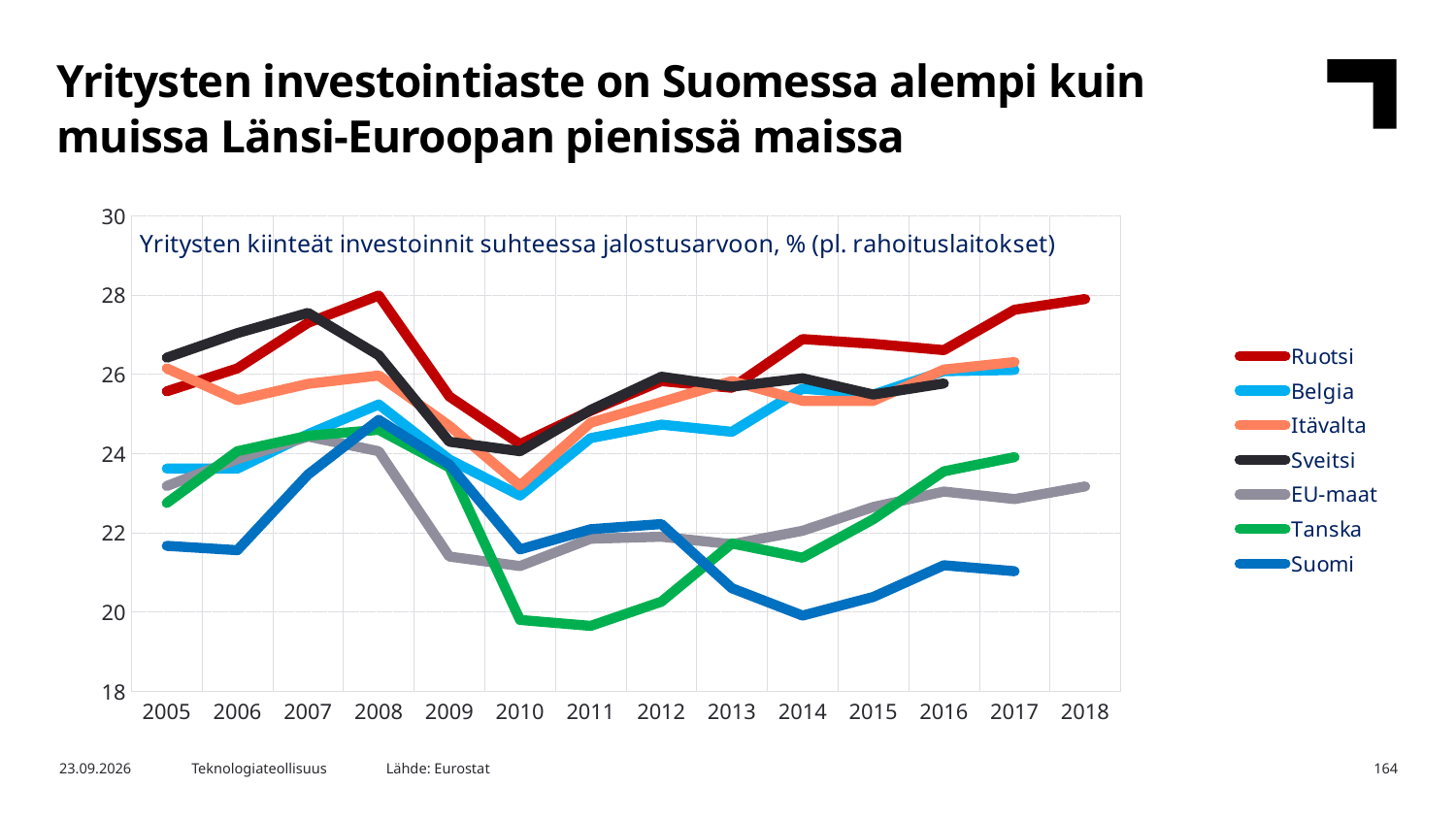
Does the value for Ruotsi rise or fall from 2016 to 2018? rise What kind of chart is shown on the slide? line chart Is the value for Tanska in 2011 greater or less than 20? less What source is cited for the chart data? Eurostat In 2018, which is larger: the value for Ruotsi or the value for EU-maat? Ruotsi Which series has the lowest value in 2014? Suomi Is the value for EU-maat in 2010 greater or less than 22? less How many series does the legend list? 7 How many years are shown on the x axis? 14 Is the value for Ruotsi in 2008 greater or less than 26? greater Which series has the highest value in 2008? Ruotsi